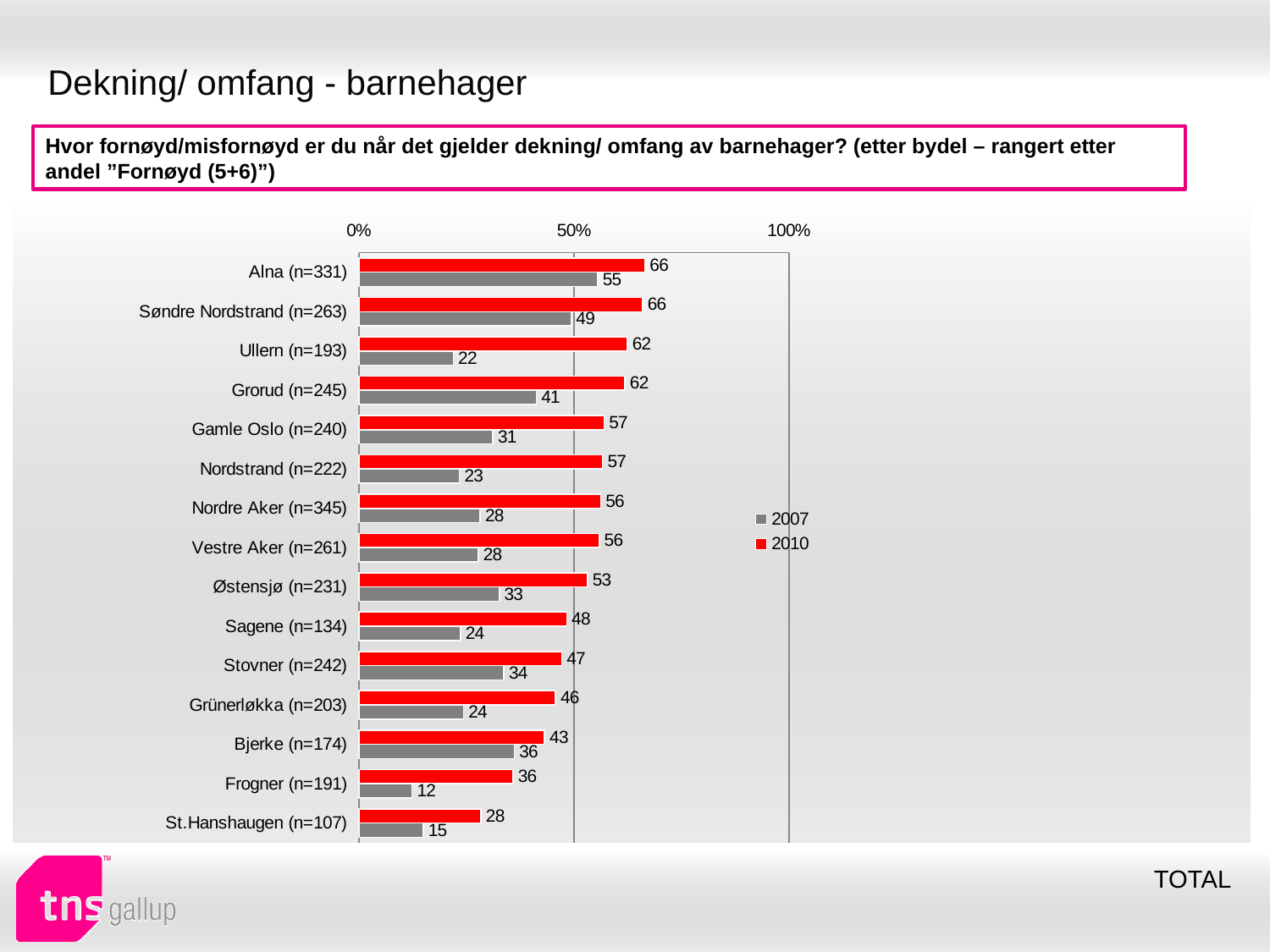
Which is larger: the 2007 value for Grorud (n=245) or the 2007 value for Gamle Oslo (n=240)? Grorud (n=245) What is the 2007 value for Frogner (n=191)? 12 Which category has the highest 2007 value? Alna (n=331) Which category has the lowest 2010 value? St.Hanshaugen (n=107) How many categories (bydeler) are shown on the chart? 15 What is the 2007 value for Stovner (n=242)? 34 What kind of chart is shown on the slide? bar chart Is the 2010 value for Alna (n=331) greater or less than 50%? greater Which colour represents the 2010 series in the legend? red What is the difference between the 2010 and 2007 values for Ullern (n=193)? 40 What is the 2010 value for Ullern (n=193)? 62 How many series does the legend list? 2